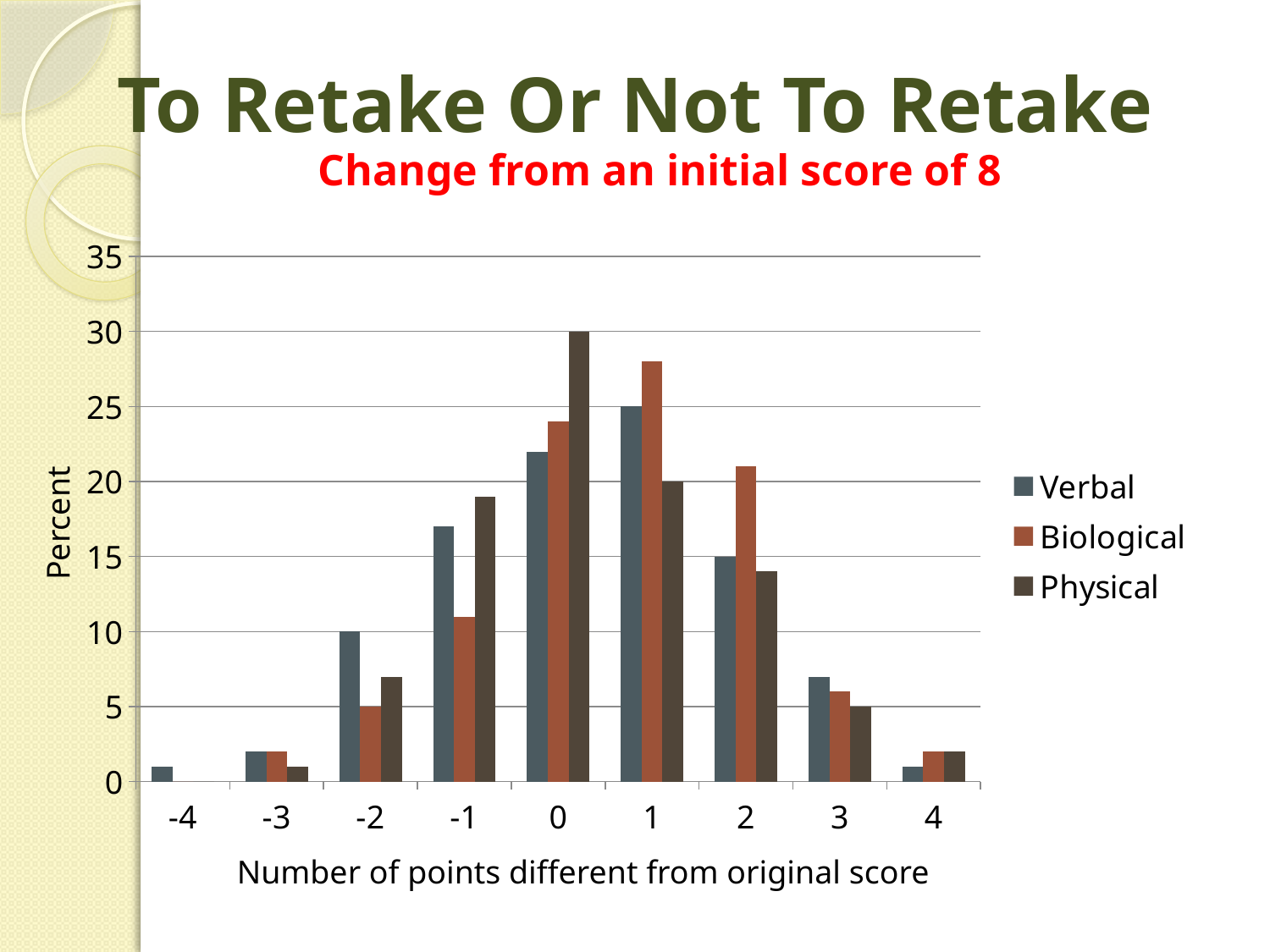
What is the Physical value at a change of 0 points? 30 What is the Verbal value at a change of 1 point? 25 How many categories are shown on the x axis? 9 Which series has the highest value at a change of 0 points? Physical What is the label of the y axis? Percent Which series has the lowest value at a change of -1 point? Biological What kind of chart is shown on the slide? bar chart Is the Biological value at a change of 1 point greater or less than 25? greater Is the Physical value at a change of -1 point greater or less than 20? less What is the Verbal value at a change of -2 points? 10 Which is larger at a change of 2 points, Biological or Physical? Biological How many series does the legend list? 3